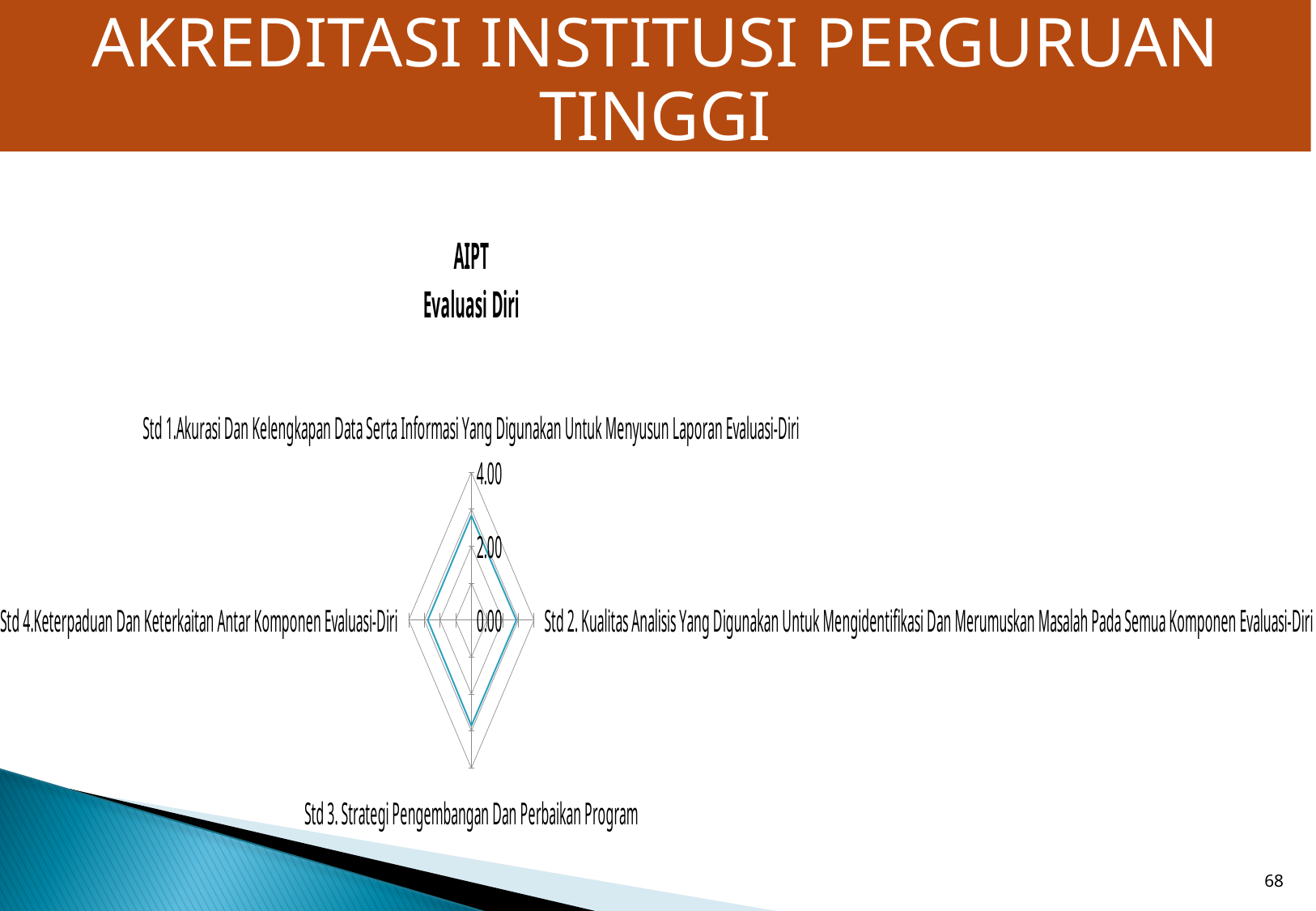
What kind of chart is shown on the slide? Radar chart Is the value for Std 2. Kualitas Analisis Yang Digunakan Untuk Mengidentifikasi Dan Merumuskan Masalah Pada Semua Komponen Evaluasi-Diri greater or less than 2.00? greater How many categories (axes) does the radar chart have? 4 What is the highest tick value shown on the radar chart's axis? 4.00 What is the title of the chart? AIPT Evaluasi Diri Is the value for Std 1.Akurasi Dan Kelengkapan Data Serta Informasi Yang Digunakan Untuk Menyusun Laporan Evaluasi-Diri greater or less than 2.00? greater Is the value for Std 4.Keterpaduan Dan Keterkaitan Antar Komponen Evaluasi-Diri greater or less than 2.00? greater